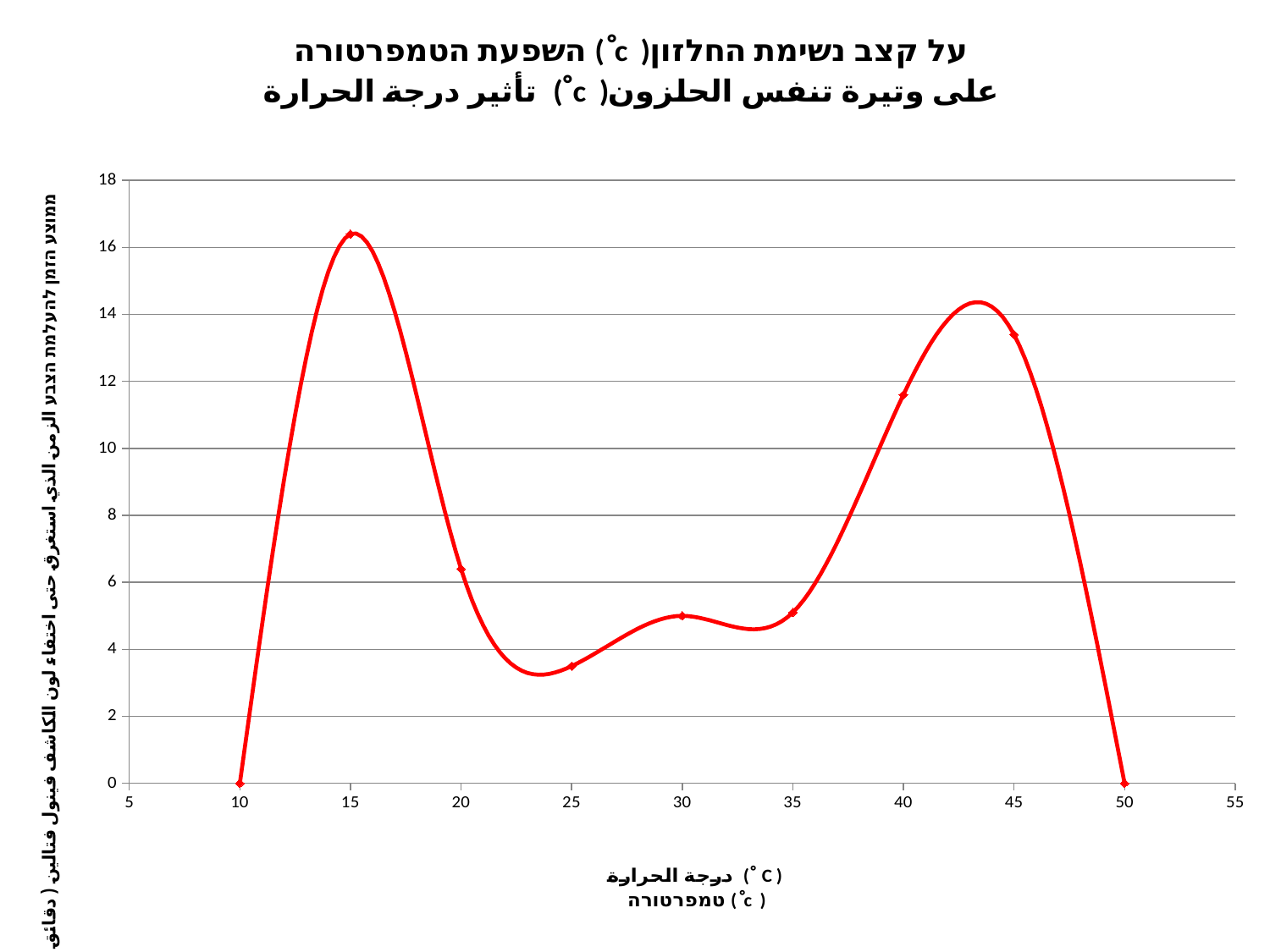
Is the value at 25 °C greater or less than 4? less How many data points are plotted on the line? 9 What is the plotted value at a temperature of 10 °C? 0 Is the value at 15 °C greater or less than 16? greater Which has the larger value, the point at 15 °C or the point at 45 °C? 15 °C What is the plotted value at a temperature of 50 °C? 0 Which has the larger value, the point at 20 °C or the point at 25 °C? 20 °C Do the values rise or fall as the temperature goes from 15 °C to 25 °C? fall Is the value at 40 °C greater or less than 10? greater What colour is the plotted line? red What kind of chart is shown on the slide? line chart At which temperature on the x axis does the line reach its highest value? 15